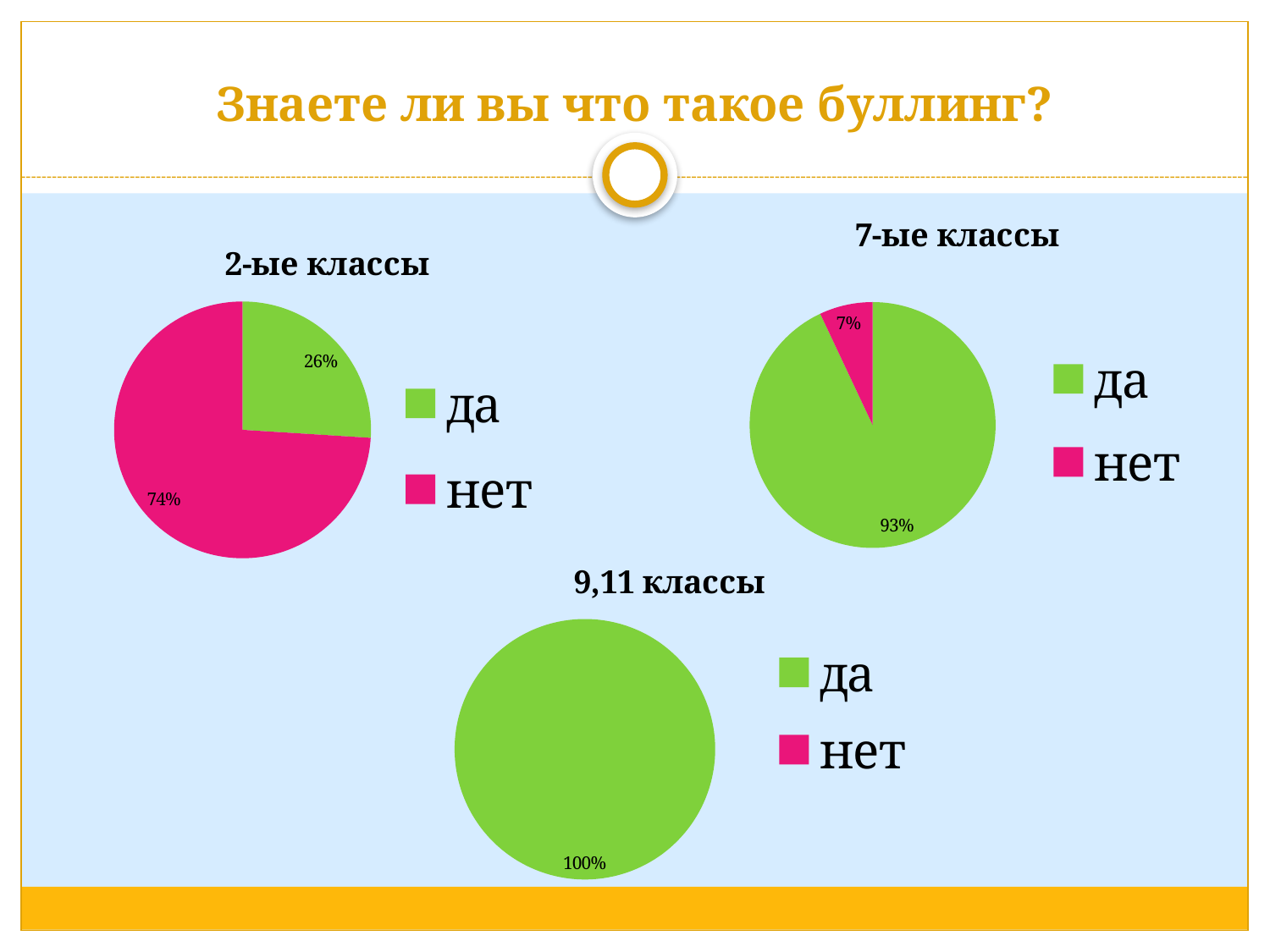
In the '7-ые классы' chart, what percentage answered 'нет'? 7% Which is larger: the 'да' share in the '2-ые классы' chart or the 'да' share in the '7-ые классы' chart? 7-ые классы In the '2-ые классы' chart, what percentage answered 'да'? 26% In the '7-ые классы' chart, which answer has the smallest share? нет How many series does the legend of the '7-ые классы' chart list? 2 In the '2-ые классы' chart, what percentage answered 'нет'? 74% In the '2-ые классы' chart, what is the difference between the 'нет' and 'да' shares? 48% In the '2-ые классы' chart, which answer has the largest share? нет In the '9,11 классы' chart, what percentage answered 'да'? 100% In the '7-ые классы' chart, what is the difference between the 'да' and 'нет' shares? 86% In the '7-ые классы' chart, what percentage answered 'да'? 93% What type of chart is used for '9,11 классы'? pie chart